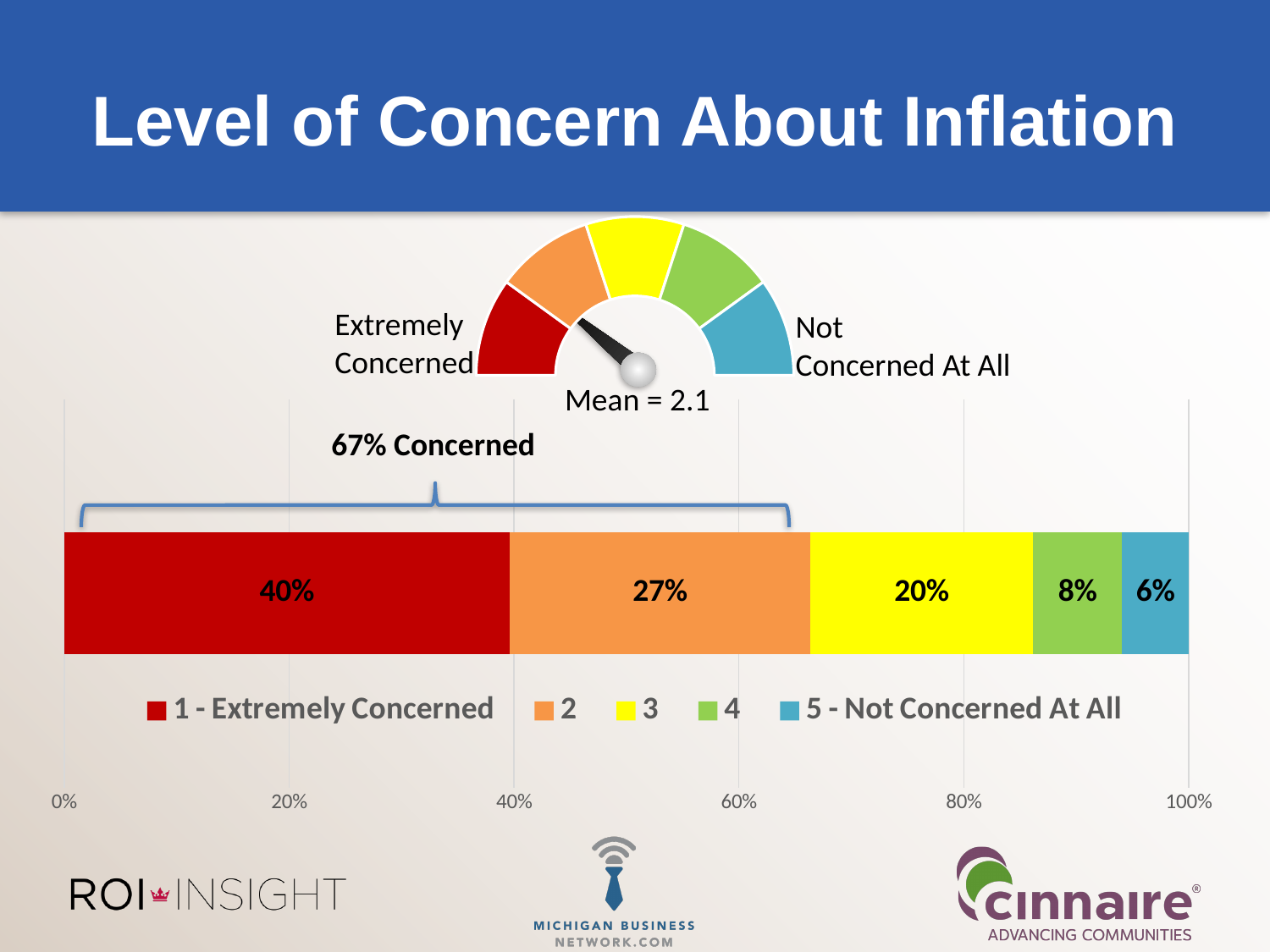
What is the difference in percentage points between the '1 - Extremely Concerned' and '2' segments? 13 percentage points What percentage of respondents gave a rating of 3? 20% Which response category has the smallest share? 5 - Not Concerned At All What is the combined percentage of ratings 1 and 2, labelled as 'Concerned'? 67% What percentage of respondents answered '5 - Not Concerned At All'? 6% Which is larger, the share for rating 4 or the share for rating 5? Rating 4 How many series does the legend list? 5 What is the mean level of concern shown on the gauge? 2.1 Which response category has the largest share? 1 - Extremely Concerned What is the title of the slide? Level of Concern About Inflation What percentage of respondents answered '1 - Extremely Concerned'? 40% What kind of chart is used to show the distribution of responses? Stacked bar chart